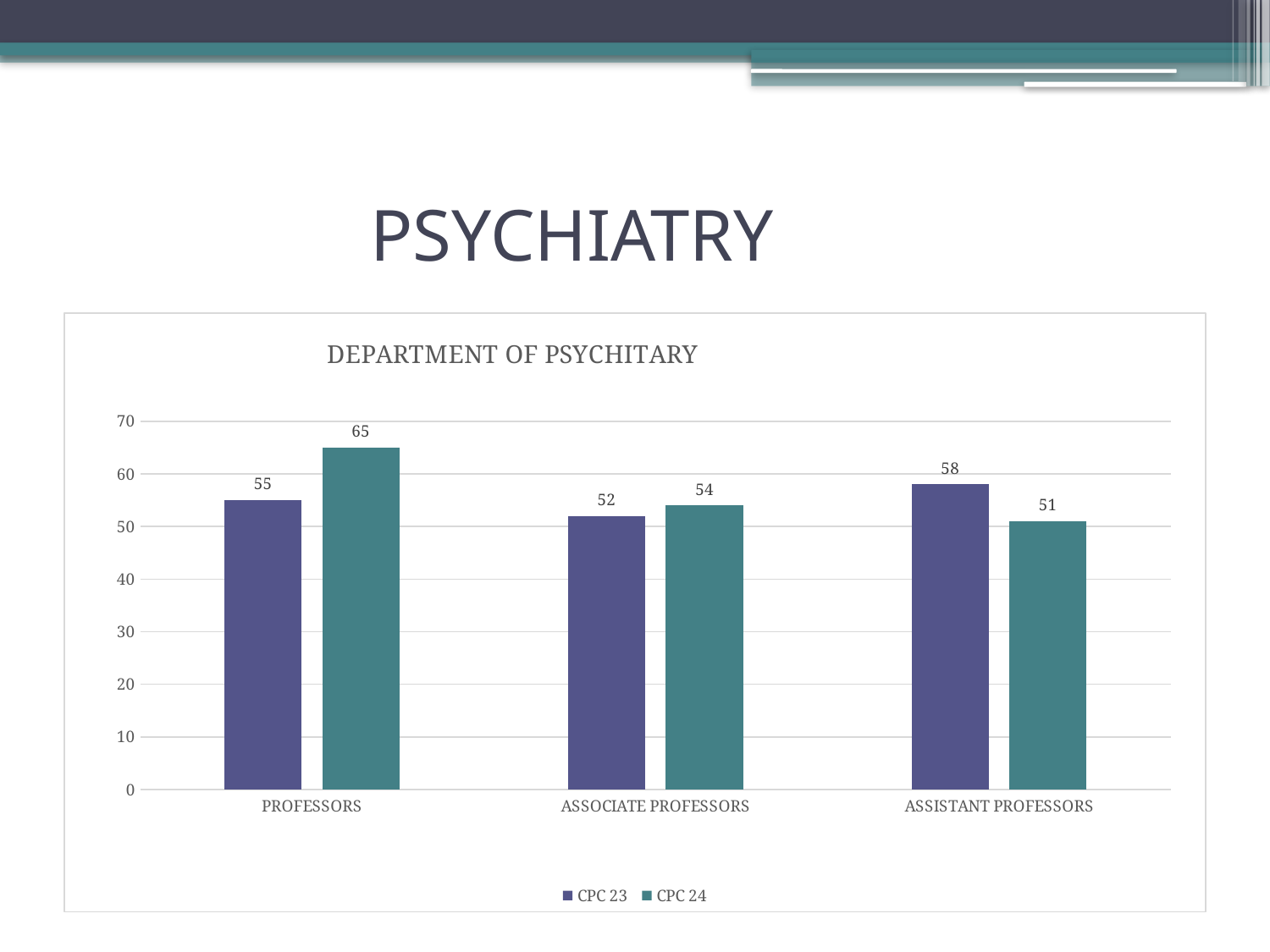
How many categories are shown on the x axis? 3 What is the CPC 24 value for PROFESSORS? 65 Which category has the highest CPC 24 value? PROFESSORS Is the CPC 24 value for PROFESSORS greater or less than 60? greater What is the CPC 23 value for ASSISTANT PROFESSORS? 58 What kind of chart is shown on the slide? Bar chart What is the title of the chart? DEPARTMENT OF PSYCHITARY What is the difference between the CPC 24 and CPC 23 values for PROFESSORS? 10 Which category has the lowest CPC 23 value? ASSOCIATE PROFESSORS What is the CPC 24 value for ASSOCIATE PROFESSORS? 54 Which is larger for ASSISTANT PROFESSORS, the CPC 23 value or the CPC 24 value? CPC 23 How many series does the legend list? 2